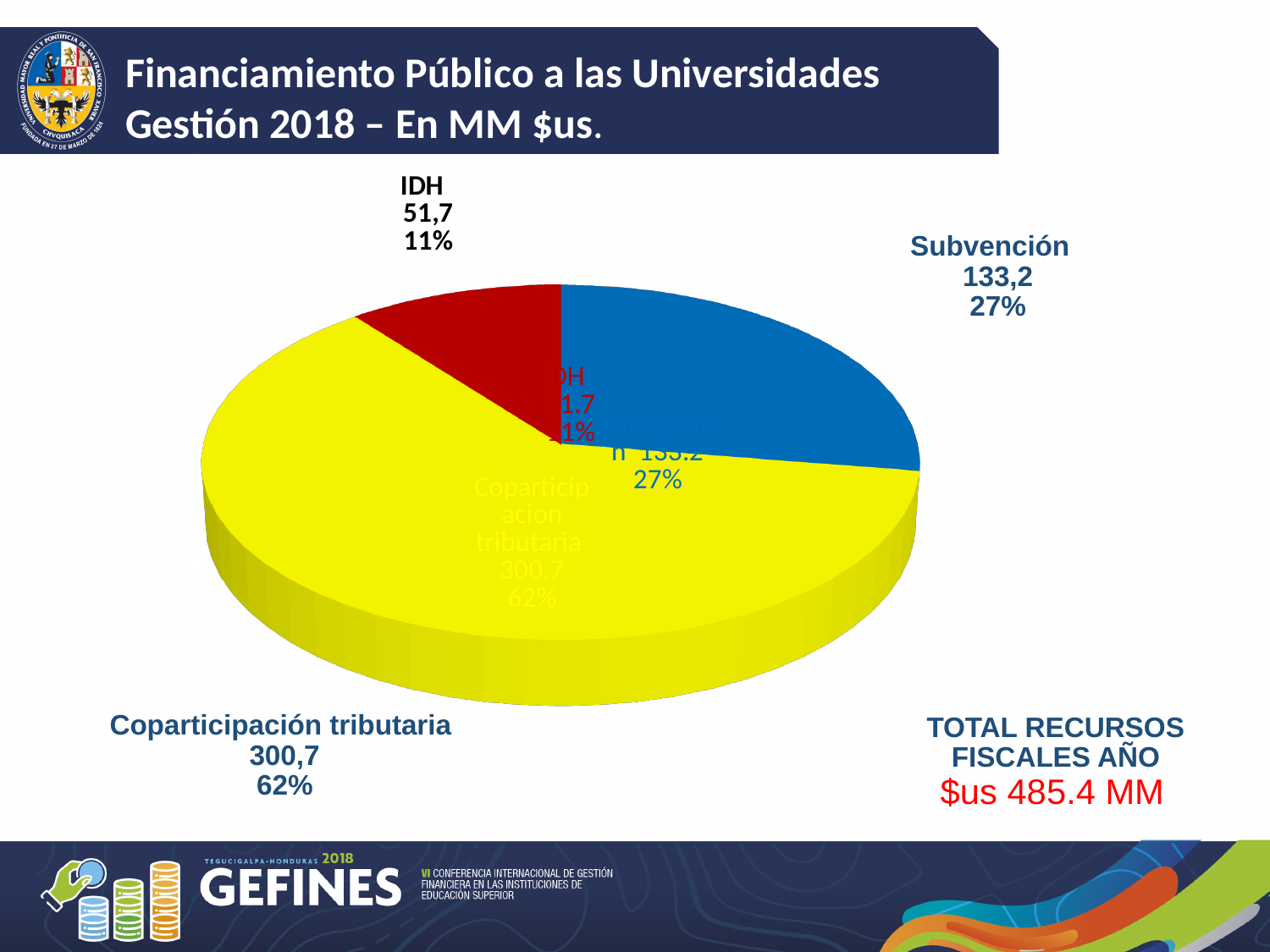
What kind of chart is shown on the slide? pie chart What is the value for Coparticipación tributaria in the pie chart? 300,7 What colour is the Coparticipación tributaria slice? yellow How many slices does the pie chart have? 3 Which is larger, Subvención or IDH? Subvención What share of the pie does Coparticipación tributaria represent? 62% Which category has the smallest slice in the pie chart? IDH What is the value for Subvención in the pie chart? 133,2 What share of the pie does IDH represent? 11% What share of the pie does Subvención represent? 27% Which category has the largest slice in the pie chart? Coparticipación tributaria What is the value for IDH in the pie chart? 51,7